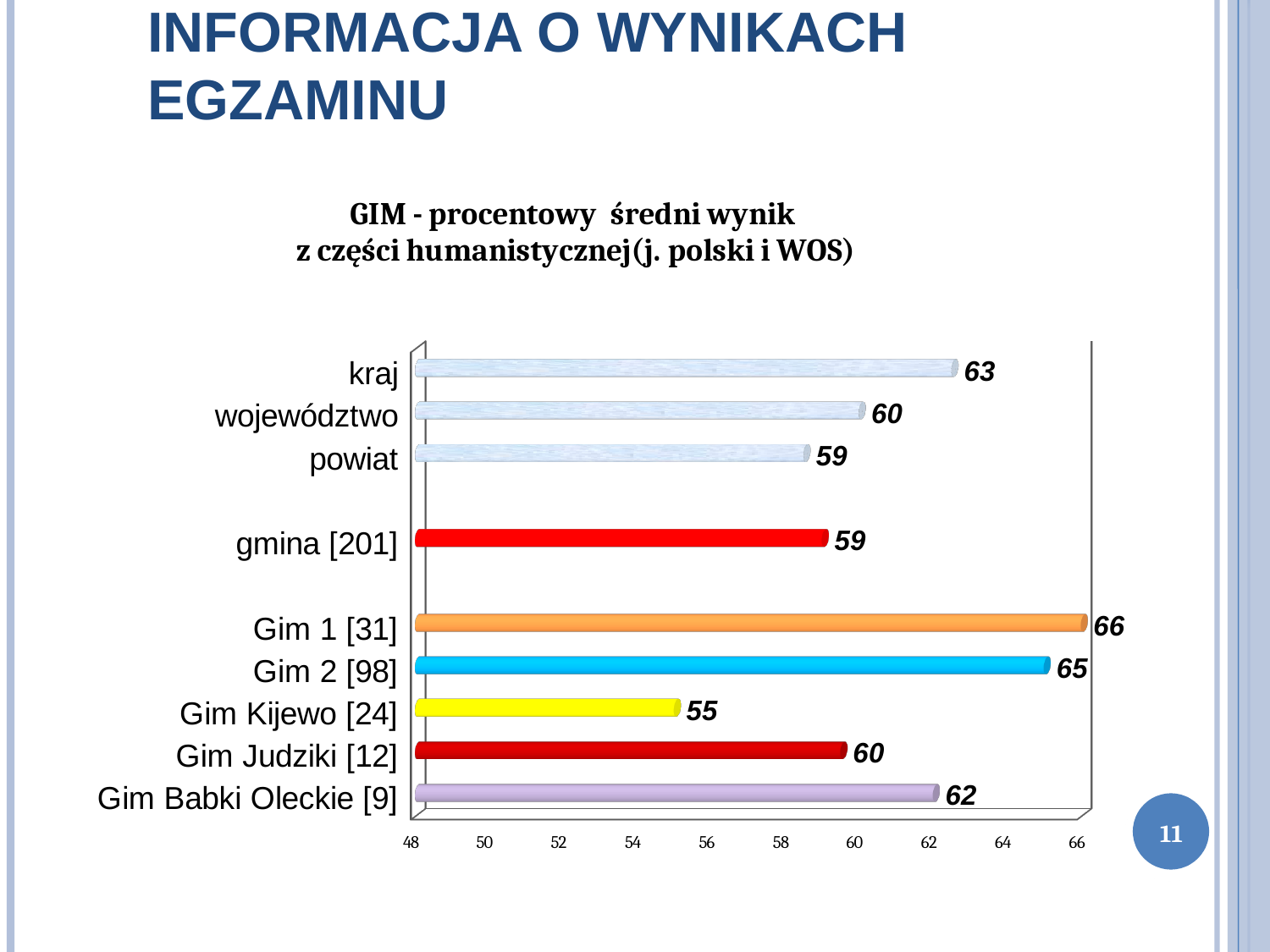
Which category has the highest value? Gim 1 [31] How many categories are shown in the chart? 9 Which is larger, the value for Gim 2 [98] or the value for województwo? Gim 2 [98] What is the value for Gim Kijewo [24]? 55 What is the difference between the values for Gim 1 [31] and Gim Kijewo [24]? 11 What is the value for kraj? 63 What is the difference between the values for kraj and powiat? 4 What is the value for gmina [201]? 59 What kind of chart is shown on the slide? bar chart What is the title of the chart? GIM - procentowy średni wynik z części humanistycznej(j. polski i WOS) What is the value for Gim Babki Oleckie [9]? 62 Which category has the lowest value? Gim Kijewo [24]